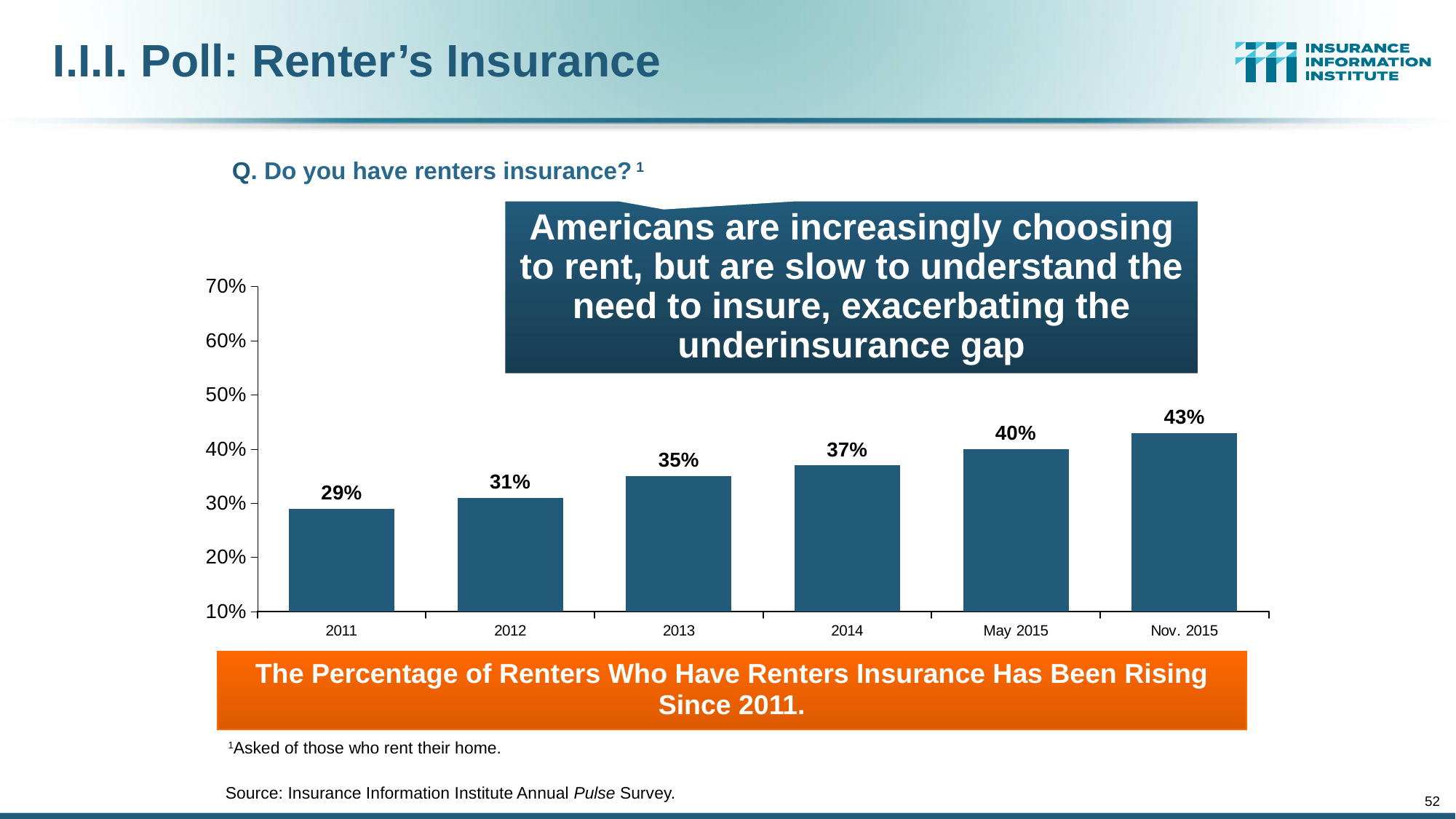
Which period has the lowest percentage of renters with renters insurance? 2011 What percentage of renters had renters insurance in 2011? 29% Which is larger, the value for 2012 or the value for 2014? 2014 Which period has the highest percentage of renters with renters insurance? Nov. 2015 What is the difference between the 2014 value and the 2013 value? 2% What is the value shown for Nov. 2015? 43% How many bars are shown in the chart? 6 What is the value shown for May 2015? 40% Do the values rise or fall from 2011 to Nov. 2015? rise What is the difference between the Nov. 2015 value and the 2011 value? 14% What kind of chart is shown on the slide? bar chart Is the value for 2013 greater or less than 40%? less